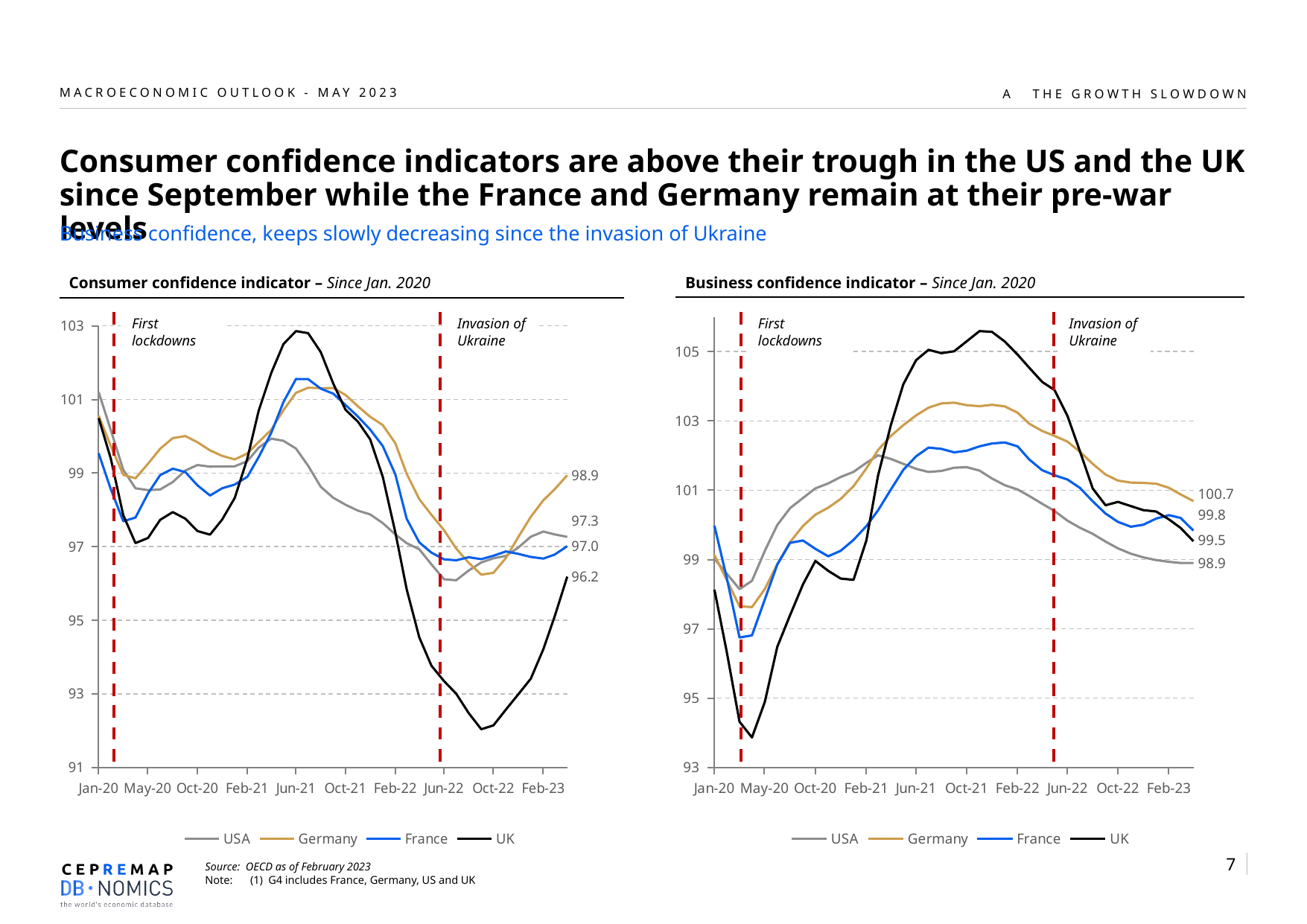
On the Consumer confidence indicator chart, what is the difference between the latest values for Germany and the UK? 2.7 On the Consumer confidence indicator chart, which country has the highest latest value? Germany What kind of chart is the Business confidence indicator chart? Line chart On the Business confidence indicator chart, which country has the lowest latest value? USA On the Consumer confidence indicator chart, what is the latest value shown for Germany? 98.9 On the Business confidence indicator chart, what is the latest value shown for the USA? 98.9 On the Business confidence indicator chart, is the UK value at its peak around Oct-21 greater or less than 105? greater On the Consumer confidence indicator chart, what is the latest value shown for the USA? 97.3 On the Business confidence indicator chart, what is the latest value shown for Germany? 100.7 How many series does the legend of the Consumer confidence indicator chart list? 4 On the Consumer confidence indicator chart, what is the latest value shown for the UK? 96.2 On the Business confidence indicator chart, which is larger, the latest value for France or for the UK? France